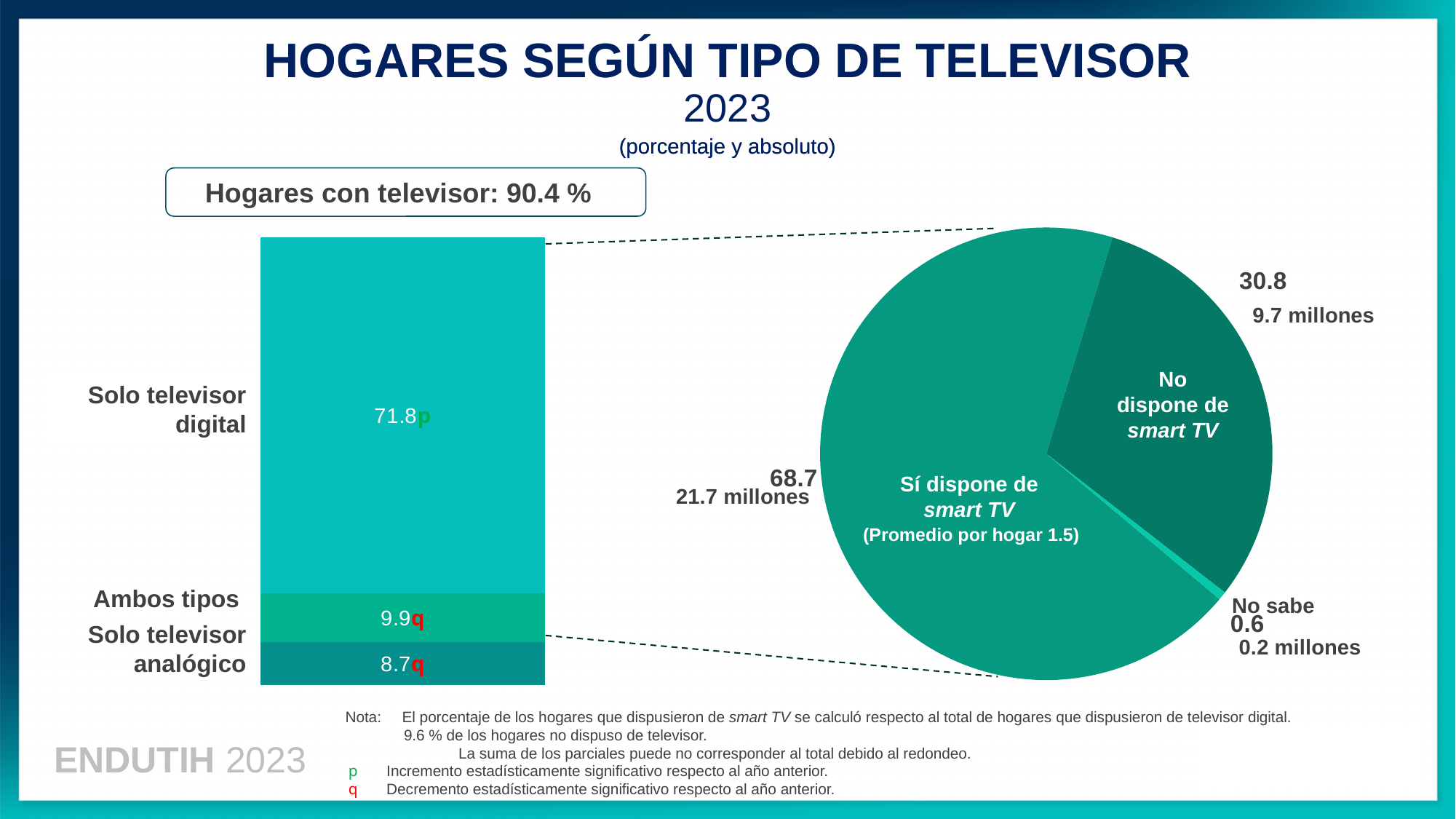
In the stacked bar chart on the left, which segment is the largest? Solo televisor digital In the stacked bar chart on the left, what is the difference between 'Solo televisor digital' and 'Ambos tipos'? 61.9 In the stacked bar chart on the left, what is the value for 'Solo televisor digital'? 71.8 In the stacked bar chart on the left, what is the value for 'Solo televisor analógico'? 8.7 In the pie chart on the right, what is the difference in percentage points between 'Sí dispone de smart TV' and 'No dispone de smart TV'? 37.9 In the pie chart on the right, how many slices are there? 3 In the stacked bar chart on the left, what is the value for 'Ambos tipos'? 9.9 In the pie chart on the right, how many millions of households 'No dispone de smart TV'? 9.7 millones In the pie chart on the right, what is the value for 'No sabe'? 0.6 In the pie chart on the right, what percentage of households 'Sí dispone de smart TV'? 68.7 In the stacked bar chart on the left, what is the total of the three segments? 90.4 In the stacked bar chart on the left, which segment is the smallest? Solo televisor analógico